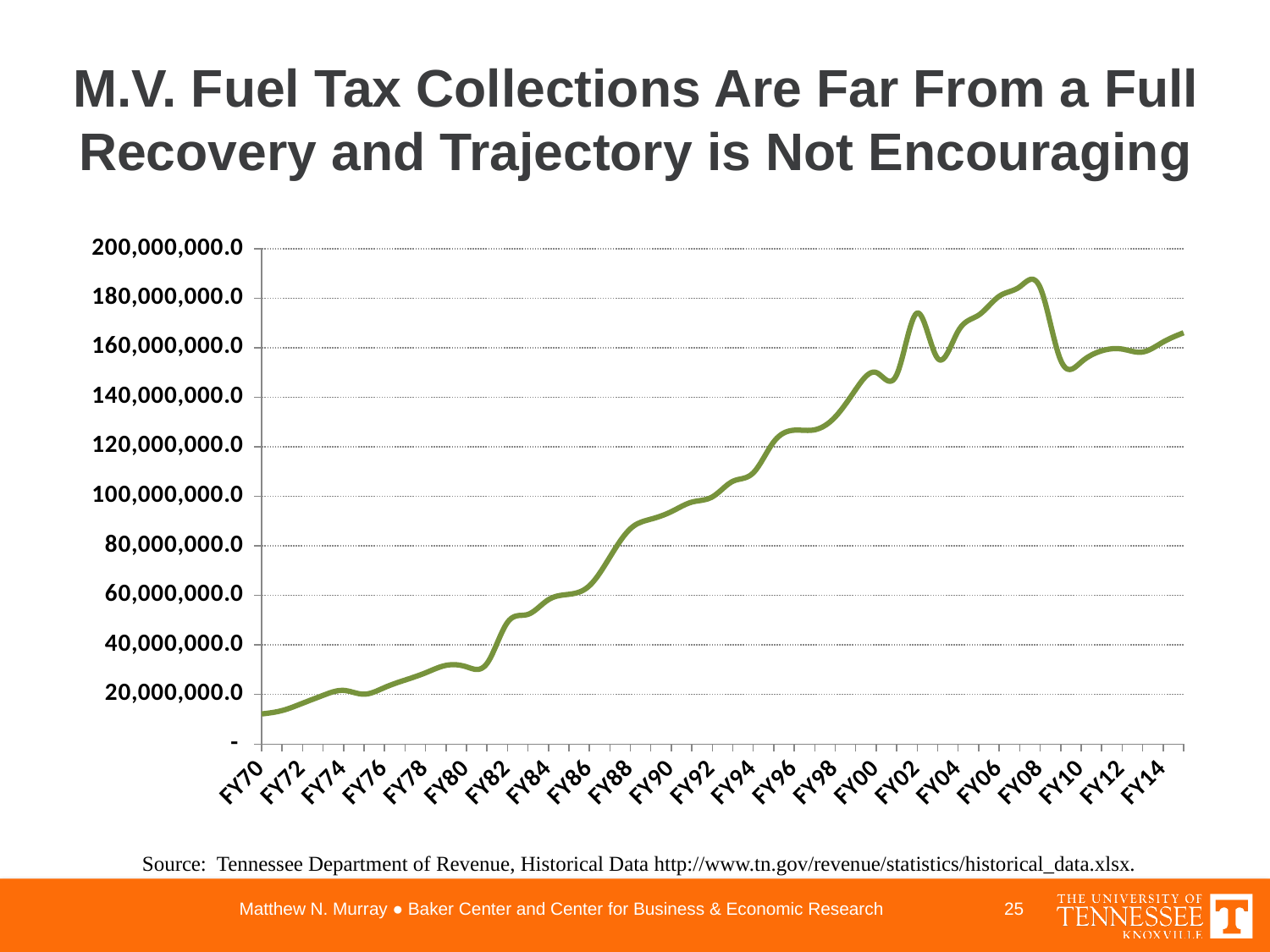
What is the title of the slide's chart? M.V. Fuel Tax Collections Are Far From a Full Recovery and Trajectory is Not Encouraging What colour is the line plotted on the chart? green In which fiscal year is the value lowest? FY70 Is the value for FY90 greater or less than 100,000,000.0? less Is the value for FY70 greater or less than 20,000,000.0? less Overall, do fuel tax collections rise or fall from FY70 to FY14? rise What kind of chart is shown on the slide? line chart Is the value for FY08 greater or less than 180,000,000.0? greater Which is higher, the value for FY08 or the value for FY14? FY08 How many fiscal years are labeled on the x axis? 23